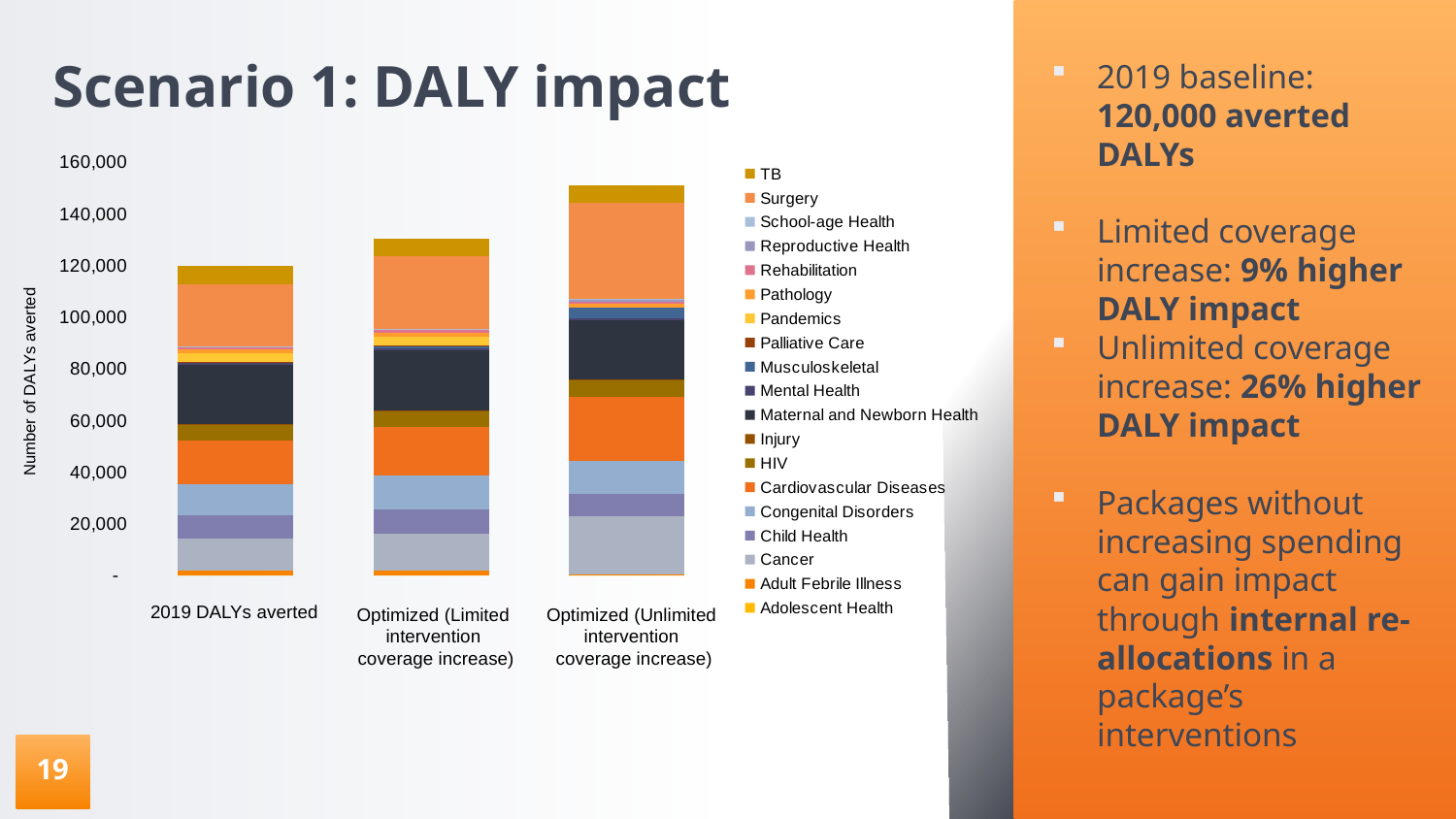
What is the highest value shown on the vertical axis? 160,000 Is the total for the Optimized (Limited intervention coverage increase) bar greater or less than 120,000? greater Which scenario has the tallest stacked bar? Optimized (Unlimited intervention coverage increase) Do the total DALYs averted rise or fall moving from left to right across the three bars? Rise How many bars (scenarios) are plotted in the chart? 3 Is the total for the 2019 DALYs averted bar greater or less than 140,000? less What is the label on the vertical axis of the chart? Number of DALYs averted How many series does the chart legend list? 19 Which scenario has the shortest stacked bar? 2019 DALYs averted Is the total for the Optimized (Unlimited intervention coverage increase) bar greater or less than 140,000? greater Which bar is taller: Optimized (Limited intervention coverage increase) or Optimized (Unlimited intervention coverage increase)? Optimized (Unlimited intervention coverage increase) What kind of chart is shown on the slide? Stacked bar chart